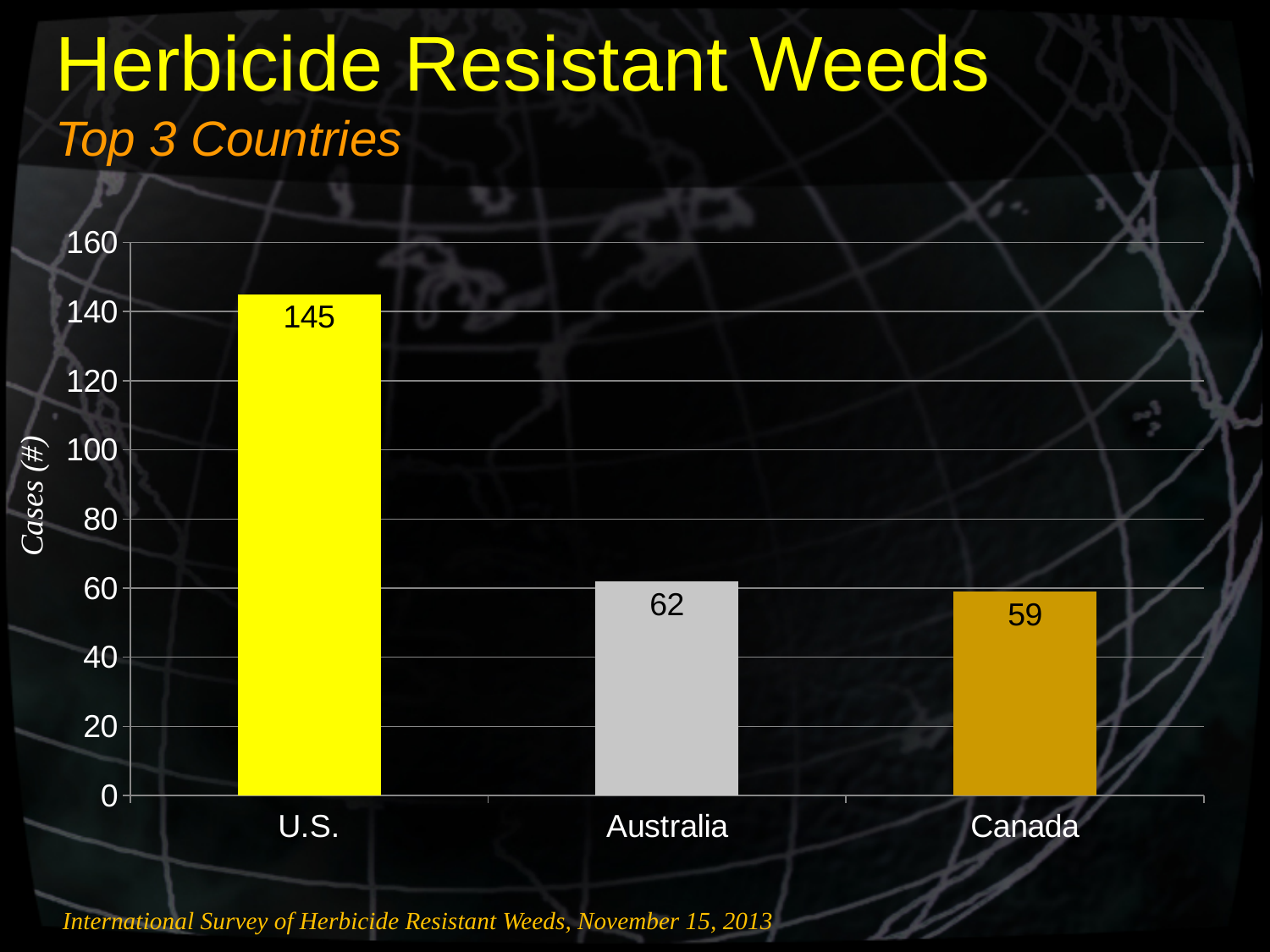
What kind of chart is shown on the slide? bar chart Which has more cases, the U.S. or Canada? U.S. Which country has the lowest number of cases? Canada What is the difference in cases between the U.S. and Australia? 83 What is the value for Canada? 59 How many countries are shown in the chart? 3 Which country has the highest number of cases? U.S. What is the value for Australia? 62 Is the value for Canada greater or less than 60? less How many herbicide resistant weed cases are shown for the U.S.? 145 What is the difference in cases between Australia and Canada? 3 What is the label on the vertical axis? Cases (#)